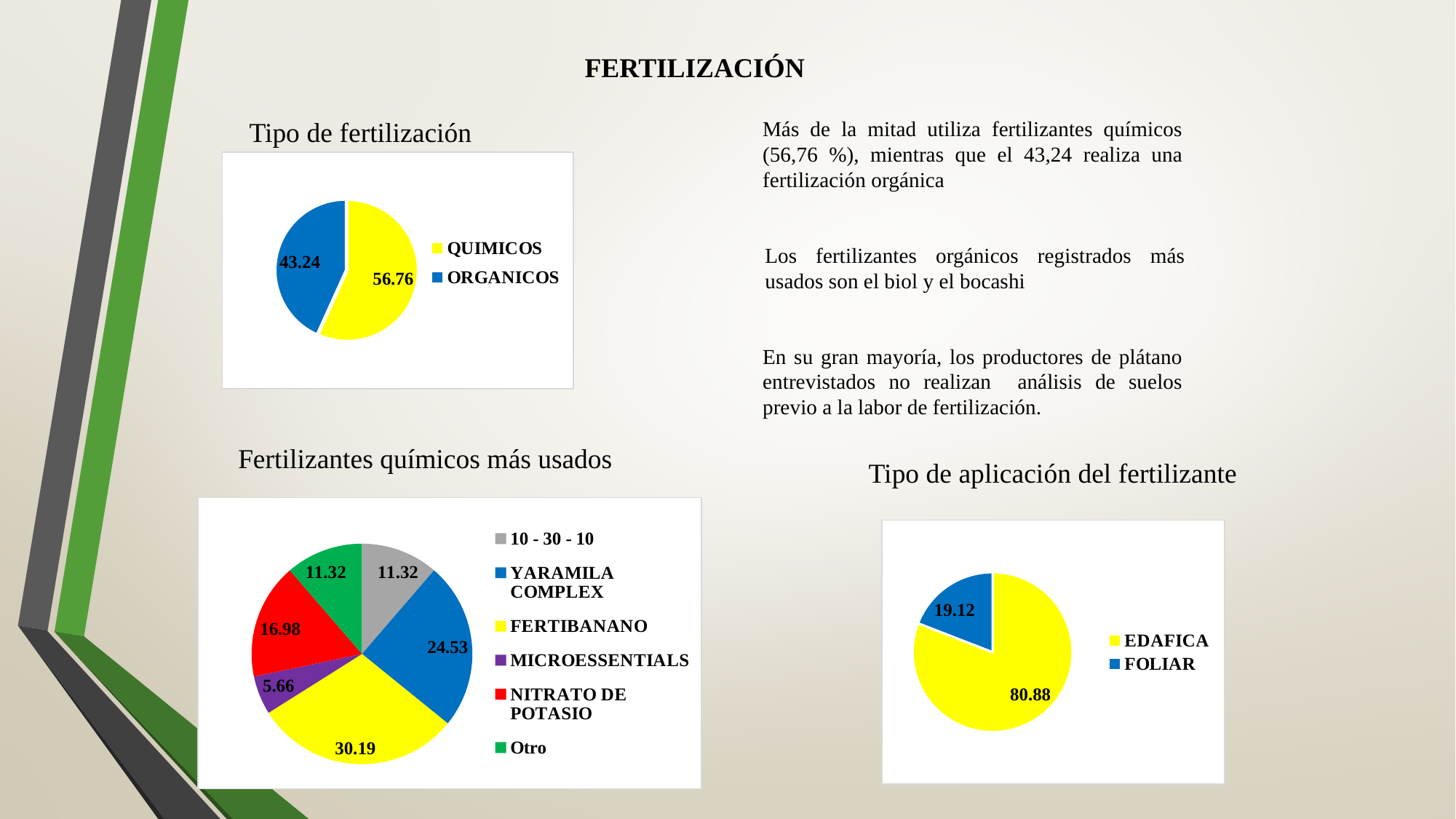
In the 'Fertilizantes químicos más usados' chart, which category has the largest slice? FERTIBANANO How many categories does the legend of the 'Fertilizantes químicos más usados' chart list? 6 In the 'Tipo de fertilización' chart, what is the value for ORGANICOS? 43.24 In the 'Fertilizantes químicos más usados' chart, which category has the smallest slice? MICROESSENTIALS In the 'Tipo de fertilización' chart, what is the difference between the QUIMICOS and ORGANICOS values? 13.52 In the 'Tipo de aplicación del fertilizante' chart, what is the difference between the EDAFICA and FOLIAR values? 61.76 In the 'Fertilizantes químicos más usados' chart, what colour is the NITRATO DE POTASIO slice? Red In the 'Tipo de fertilización' chart, what is the value for QUIMICOS? 56.76 In the 'Fertilizantes químicos más usados' chart, what is the value for FERTIBANANO? 30.19 In the 'Fertilizantes químicos más usados' chart, which is larger: YARAMILA COMPLEX or NITRATO DE POTASIO? YARAMILA COMPLEX In the 'Tipo de aplicación del fertilizante' chart, what is the value for FOLIAR? 19.12 What kind of chart is the 'Tipo de fertilización' chart? Pie chart